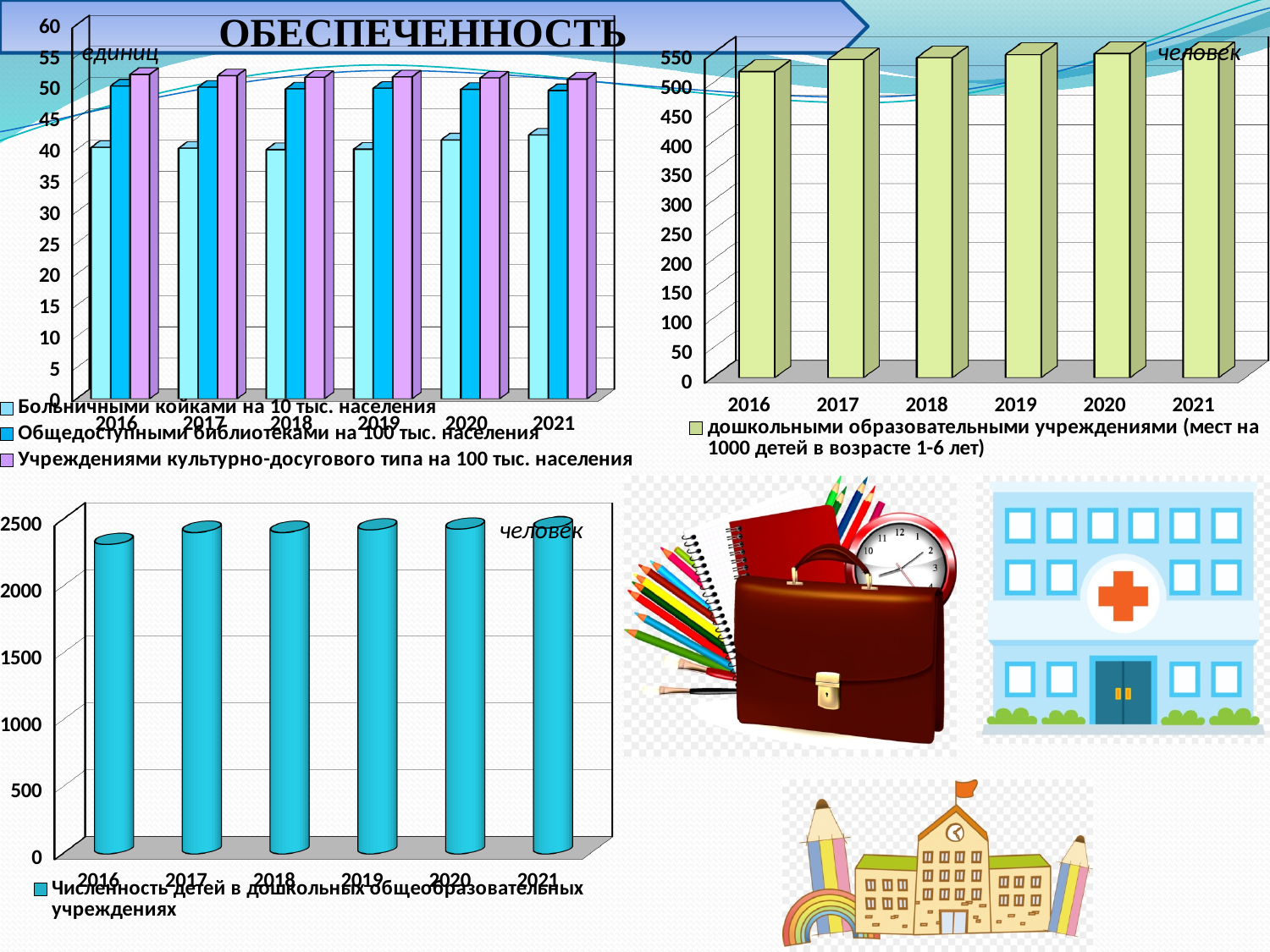
What unit label is shown at the top of the y axis of the top-left chart? единиц In the top-left chart, is the value for Общедоступными библиотеками на 100 тыс. населения in 2018 greater or less than 45? greater What kind of chart is the top-right chart (дошкольными образовательными учреждениями)? bar chart What is the legend entry of the top-right chart? дошкольными образовательными учреждениями (мест на 1000 детей в возрасте 1-6 лет) In the top-left chart for 2016, which is larger: Учреждениями культурно-досугового типа на 100 тыс. населения or Больничными койками на 10 тыс. населения? Учреждениями культурно-досугового типа на 100 тыс. населения How many years are shown on the x axis of the bottom-left chart (Численность детей в дошкольных общеобразовательных учреждениях)? 6 In the top-left chart, is the value for Больничными койками на 10 тыс. населения in 2016 greater or less than 45? less In the top-right chart, do the values generally rise or fall from 2016 to 2021? rise In the top-right chart, is the value for 2016 greater or less than 500? greater How many series does the legend of the top-left chart list? 3